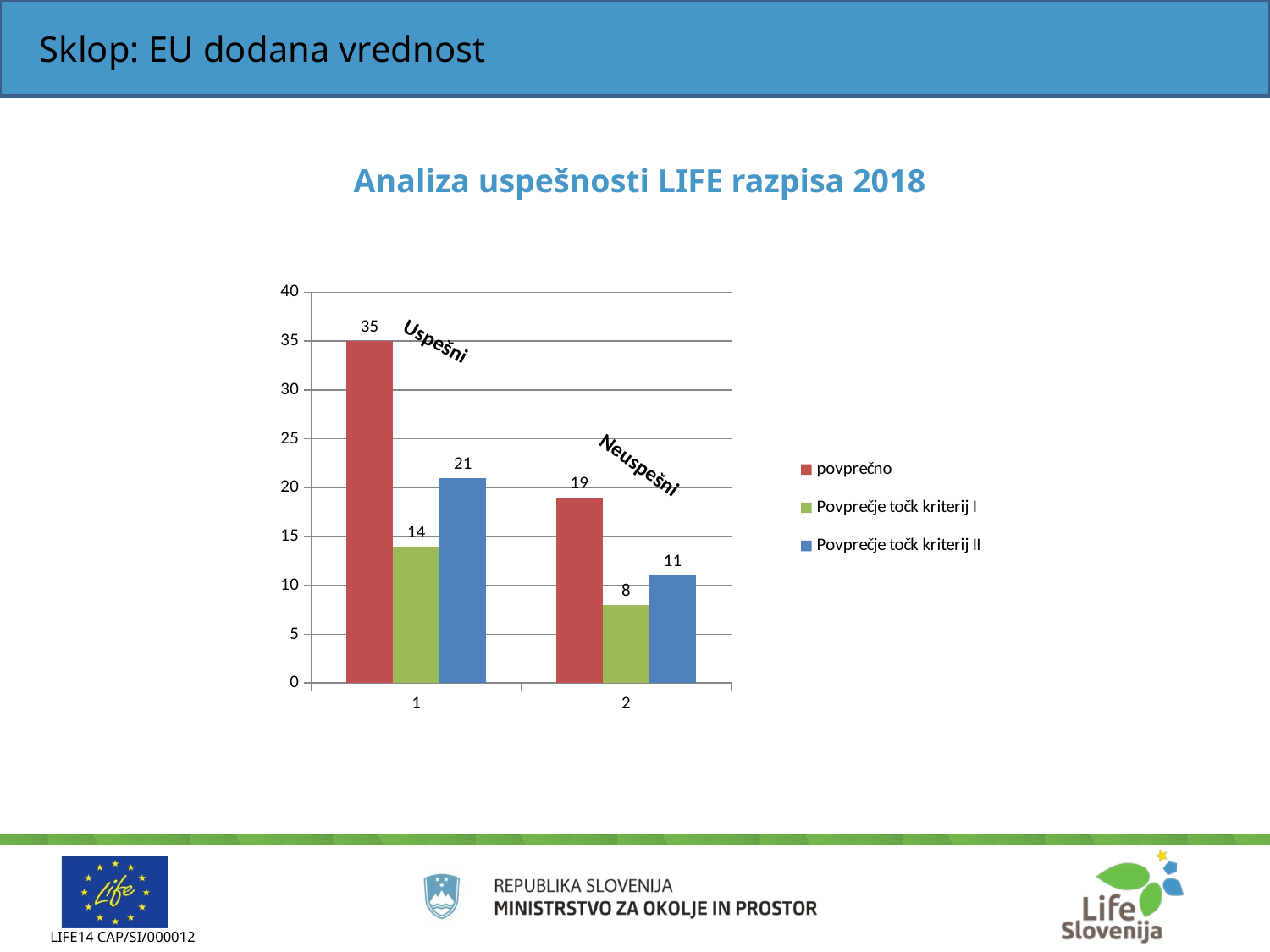
How many categories are shown on the x axis? 2 Which series has the highest value in category 2? povprečno What is the value of 'Povprečje točk kriterij II' for category 2? 11 How many series does the legend list? 3 What kind of chart is shown on the slide? Bar chart Does the 'Povprečje točk kriterij I' value rise or fall from category 1 to category 2? Fall Which series has the lowest value in category 1? Povprečje točk kriterij I What is the difference between the 'povprečno' values for category 1 and category 2? 16 What is the value of 'povprečno' for category 1? 35 What is the title of the chart? Analiza uspešnosti LIFE razpisa 2018 What is the value of 'Povprečje točk kriterij I' for category 1? 14 Which is larger: 'Povprečje točk kriterij II' for category 1 or 'povprečno' for category 2? Povprečje točk kriterij II for category 1